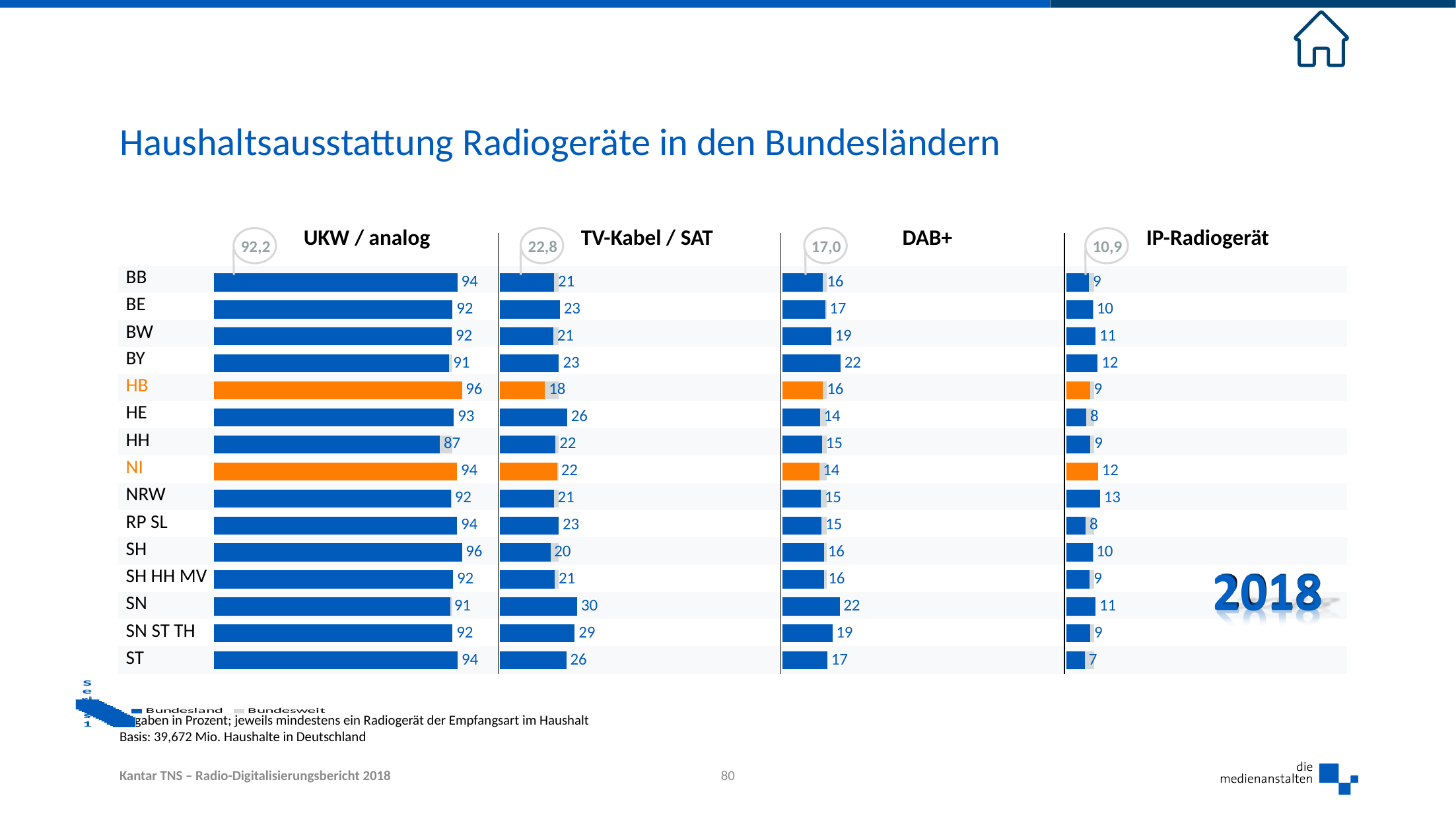
In the TV-Kabel / SAT chart, which Bundesland has the lowest value? HB In the UKW / analog chart, what is the value for HH? 87 What is the Bundesweit (nationwide) value shown for DAB+? 17,0 In the IP-Radiogerät chart, which Bundesland has the highest value? NRW In the IP-Radiogerät chart, which Bundesland has the lowest value? ST In the TV-Kabel / SAT chart, which Bundesland has the highest value? SN In the DAB+ chart, what is the value for BY? 22 In the DAB+ chart, which is larger, the value for BW or the value for HE? BW In the TV-Kabel / SAT chart, what is the difference between the values for SN and HB? 12 How many Bundesländer (categories) are listed in the UKW / analog chart? 15 In the UKW / analog chart, which Bundesland has the lowest value? HH What type of chart is used for the IP-Radiogerät panel? Bar chart